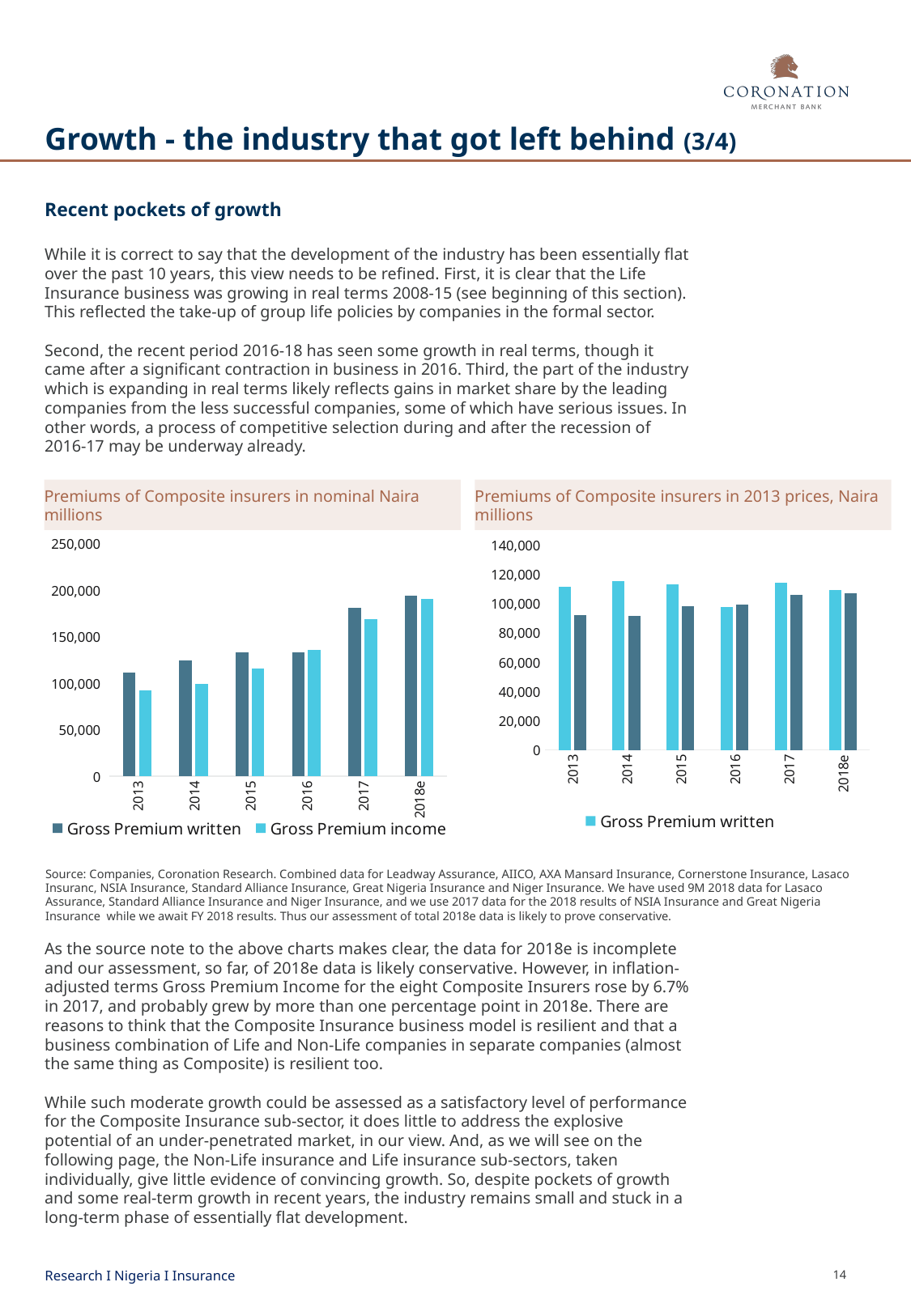
What is the title of the right chart? Premiums of Composite insurers in 2013 prices, Naira millions How many series does the legend of the right chart (2013 prices, Naira millions) list? 1 In the left chart (nominal Naira millions), which year has the lowest Gross Premium income value? 2013 What kind of chart is the left chart, 'Premiums of Composite insurers in nominal Naira millions'? bar chart In the right chart (2013 prices, Naira millions), is the Gross Premium written value for 2014 greater or less than 100,000? greater In the left chart (nominal Naira millions), is the Gross Premium income value for 2014 greater or less than 150,000? less In the left chart (nominal Naira millions), which year has the highest Gross Premium written value? 2018e How many year categories are shown on the x axis of the left chart (nominal Naira millions)? 6 In the left chart (nominal Naira millions), does Gross Premium written generally rise or fall from 2013 to 2018e? rise In the left chart (nominal Naira millions), is the Gross Premium written value for 2013 greater or less than 100,000? greater How many series does the legend of the left chart (nominal Naira millions) list? 2 In the left chart (nominal Naira millions), is Gross Premium written for 2017 larger or smaller than Gross Premium written for 2015? larger